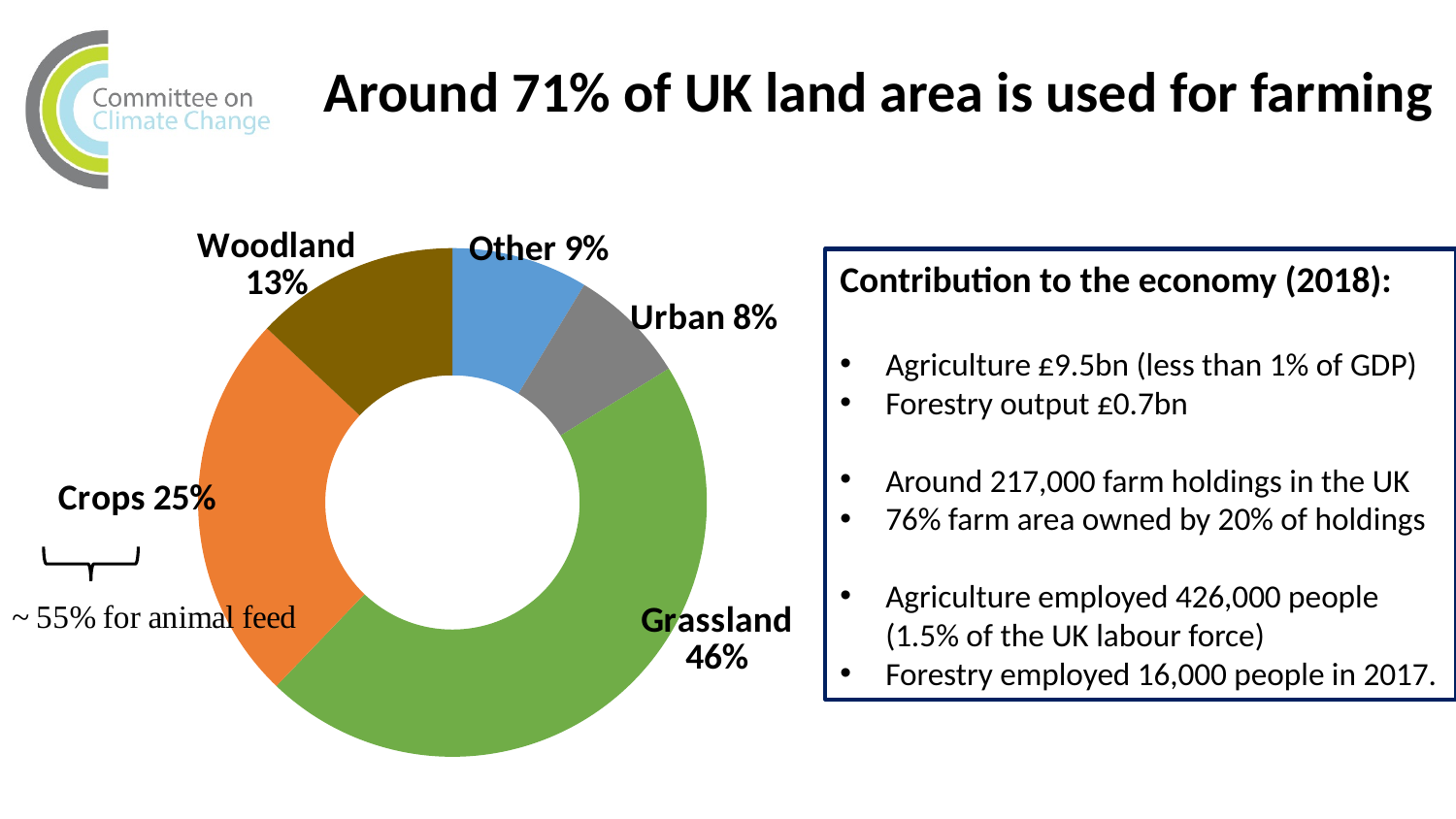
Which is larger, the share for Woodland or the share for Other? Woodland What share of UK land area is Woodland according to the chart? 13% How many categories are shown in the chart? 5 What kind of chart is shown on the slide? Doughnut (pie) chart What share of UK land area is Urban according to the chart? 8% What share of UK land area is Grassland according to the chart? 46% What is the combined share of Grassland and Crops? 71% What colour is the Grassland segment of the chart? Green What share of UK land area is Crops according to the chart? 25% Which category has the largest share of UK land area in the chart? Grassland What is the difference in percentage points between the Grassland and Crops shares? 21 Which category has the smallest share of UK land area in the chart? Urban